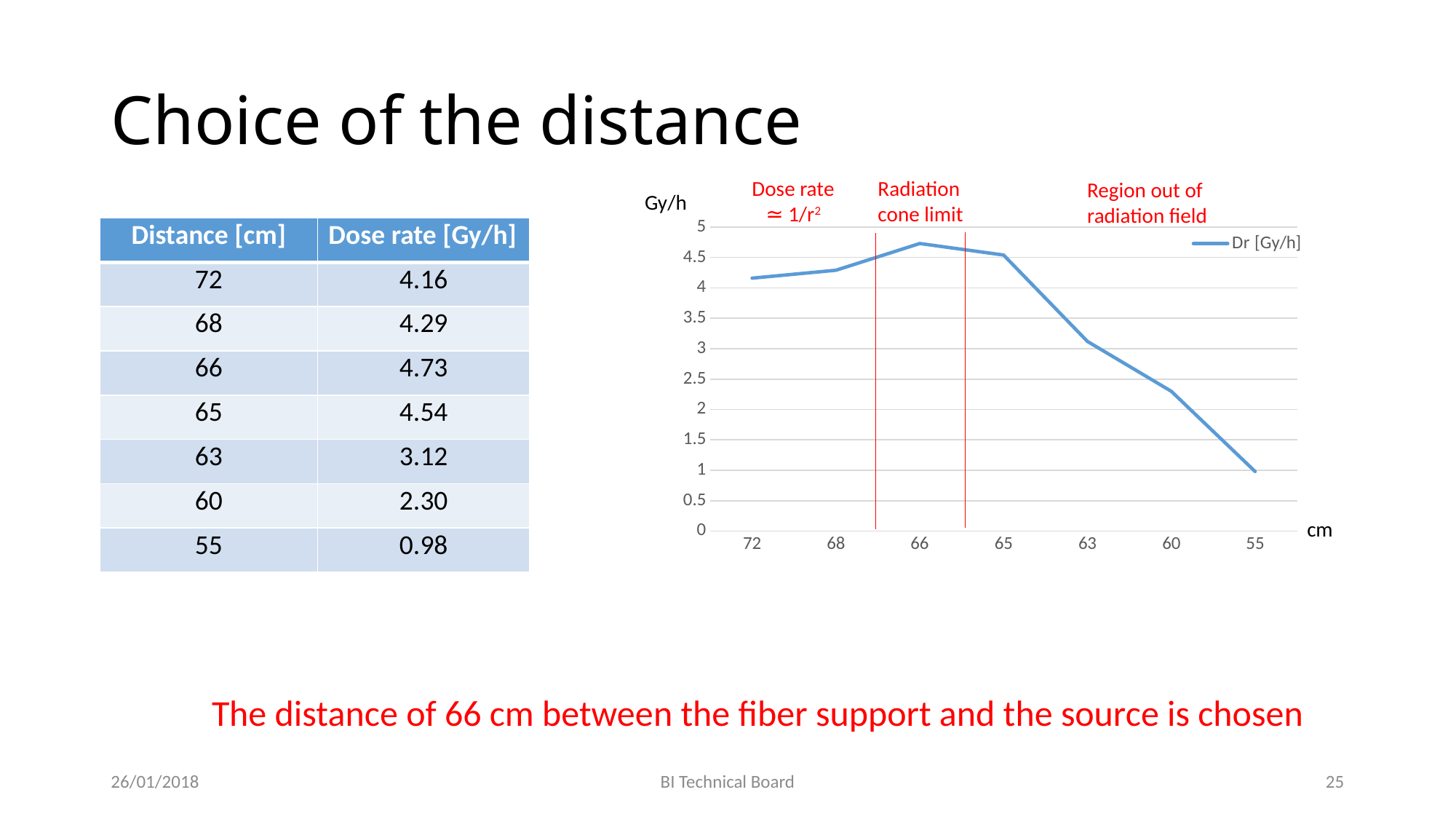
How many distance points are plotted on the chart? 7 At which distance is the dose rate lowest? 55 Is the dose rate at 63 cm greater or less than 3.5? less How many series does the chart legend list? 1 What is the difference in dose rate between 66 cm and 63 cm? 1.61 At which distance is the dose rate highest? 66 Do the dose rate values rise or fall from 65 cm to 55 cm along the x axis? fall What kind of chart is shown on the slide? line chart What is the name of the series in the chart legend? Dr [Gy/h] What is the dose rate at a distance of 66 cm? 4.73 Which has a higher dose rate, 72 cm or 60 cm? 72 cm What is the dose rate at a distance of 55 cm? 0.98